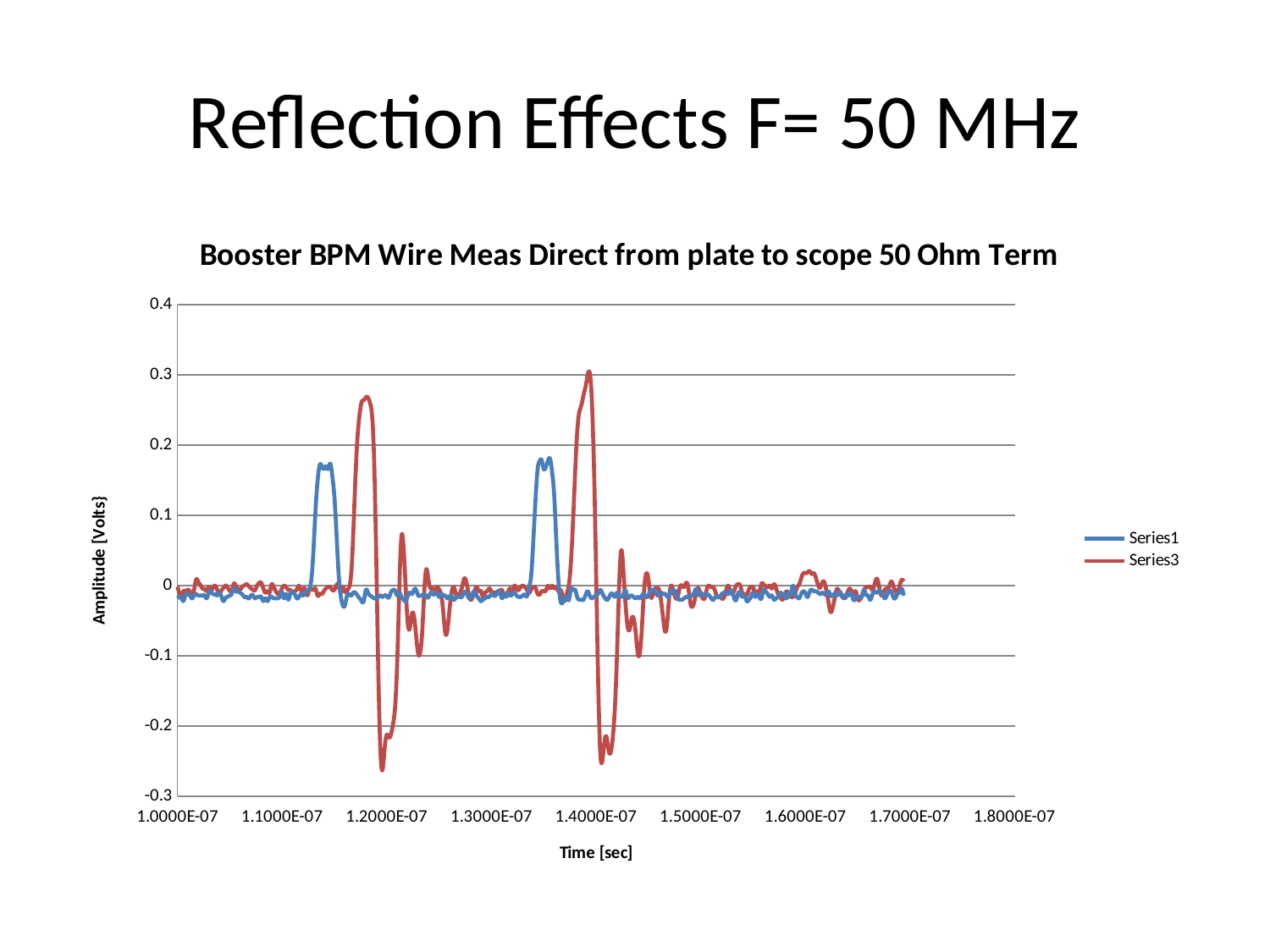
How many distinct positive pulses does Series1 show? 2 Which series reaches the higher peak amplitude, Series1 or Series3? Series3 Which series drops to the lowest amplitude on the chart? Series3 What is the title of the chart? Booster BPM Wire Meas Direct from plate to scope 50 Ohm Term Is the highest peak of Series1 greater or less than 0.1? greater What is the highest value shown on the vertical axis? 0.4 Is the highest peak of Series3 greater or less than 0.2? greater How many series does the legend list? 2 Is the highest peak of Series1 greater or less than 0.2? less What kind of chart is shown on the slide? line chart What is the label of the vertical axis? Amplitude [Volts]